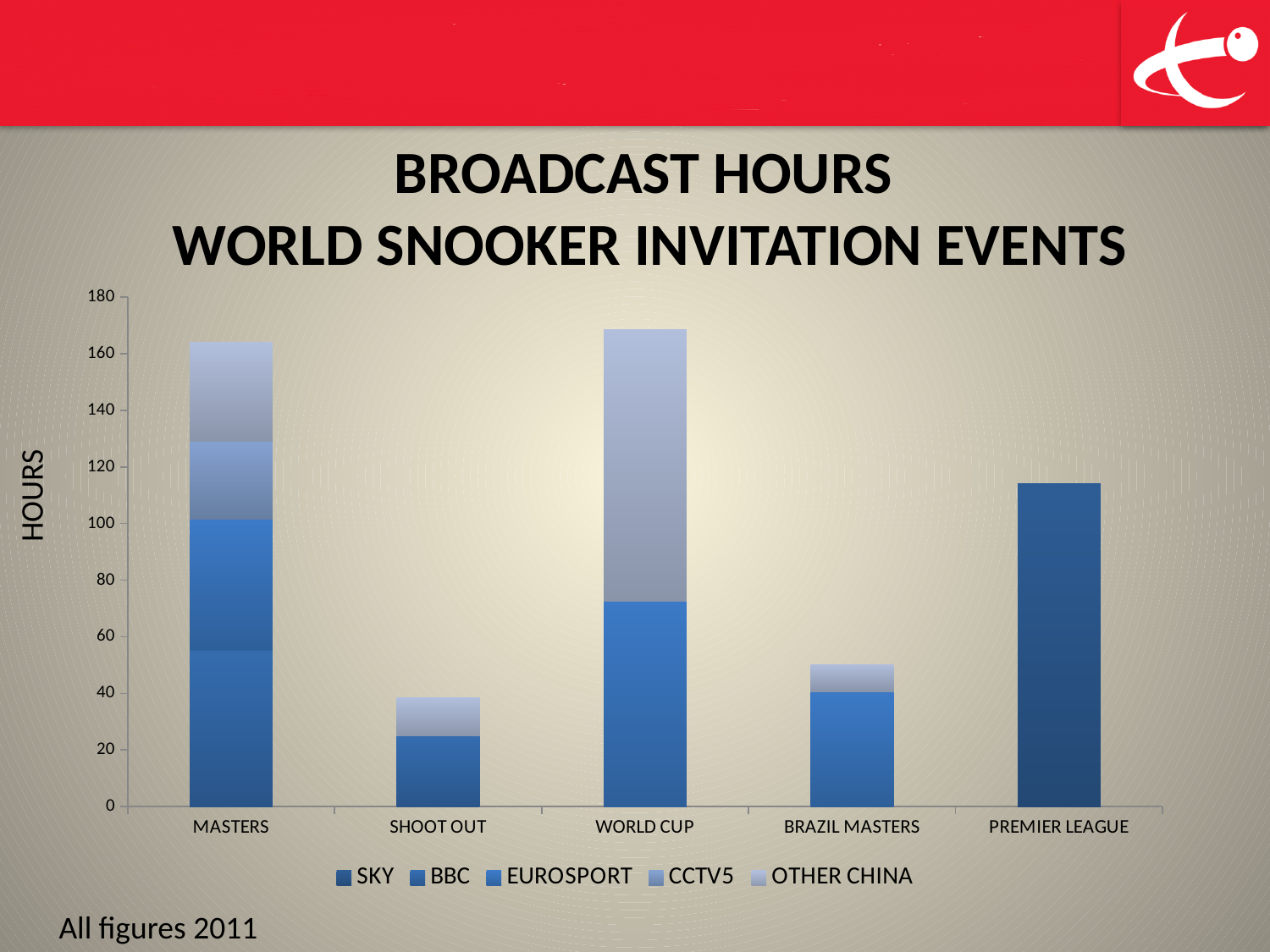
What is the label on the vertical axis of the chart? HOURS Which has the larger total broadcast hours, MASTERS or SHOOT OUT? MASTERS Is the total value for BRAZIL MASTERS greater or less than 60? less What kind of chart is shown on the slide? Stacked bar chart Is the total value for PREMIER LEAGUE greater or less than 100? greater How many events are shown along the x axis of the chart? 5 Which broadcaster is the only series shown for PREMIER LEAGUE? SKY Which event has the lowest total broadcast hours? SHOOT OUT Which has the larger total broadcast hours, PREMIER LEAGUE or BRAZIL MASTERS? PREMIER LEAGUE Is the total value for MASTERS greater or less than 140? greater How many series does the chart's legend list? 5